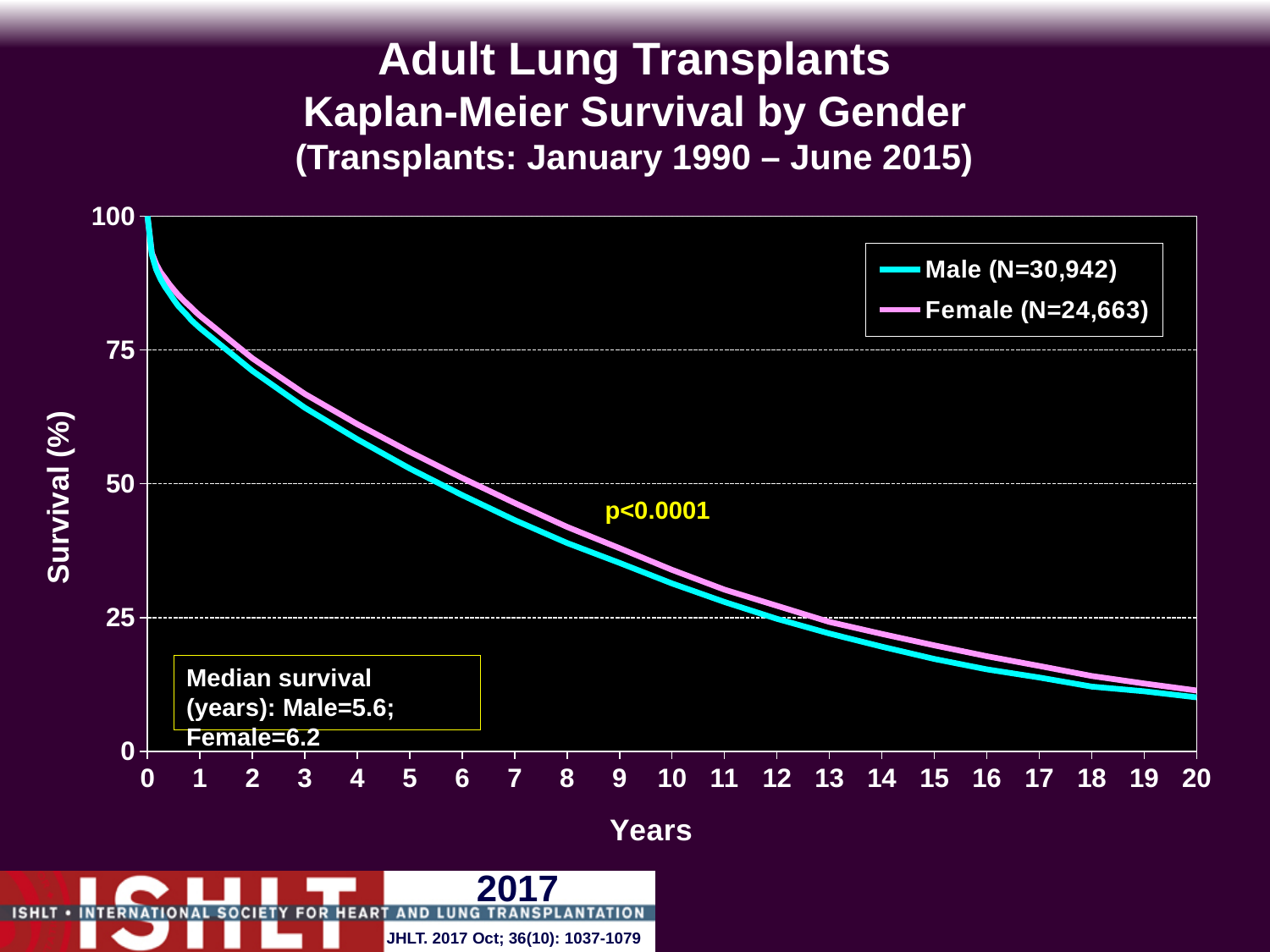
Which group has the longer median survival, Male or Female? Female What is the median survival in years for Male recipients? 5.6 Is the Female survival at 2 years greater or less than 50%? greater What is the number of Male recipients (N) shown in the legend? 30,942 What is the difference in median survival (years) between Female and Male recipients? 0.6 Do the survival curves rise or fall as years increase? Fall Is the Male survival at 10 years greater or less than 50%? less What kind of chart is shown on the slide? Line chart Is the Male survival at 20 years greater or less than 25%? less How many series does the legend list? 2 What p-value is printed on the chart? p<0.0001 What is the median survival in years for Female recipients? 6.2